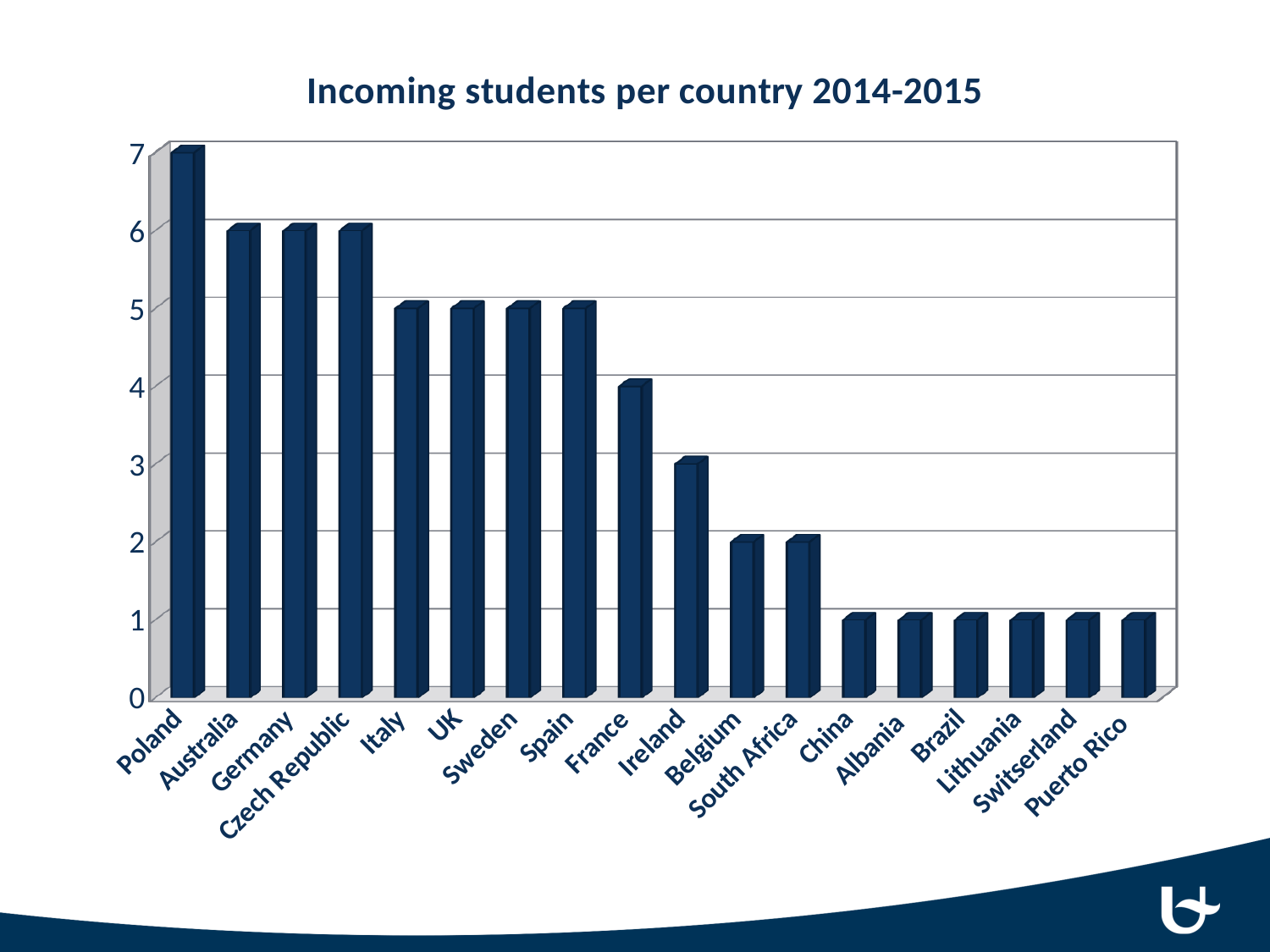
How many countries are shown on the chart? 18 Do the values generally rise or fall from left to right along the x axis? fall What is the difference between the number of incoming students from Poland and from Ireland? 4 Is the value for Czech Republic greater or less than 5? greater How many incoming students came from Poland? 7 Which country has the highest number of incoming students? Poland How many incoming students came from France? 4 What kind of chart is shown on the slide? bar chart How many incoming students came from Ireland? 3 Which has more incoming students, Germany or Italy? Germany How many incoming students came from Belgium? 2 What is the title of the chart? Incoming students per country 2014-2015